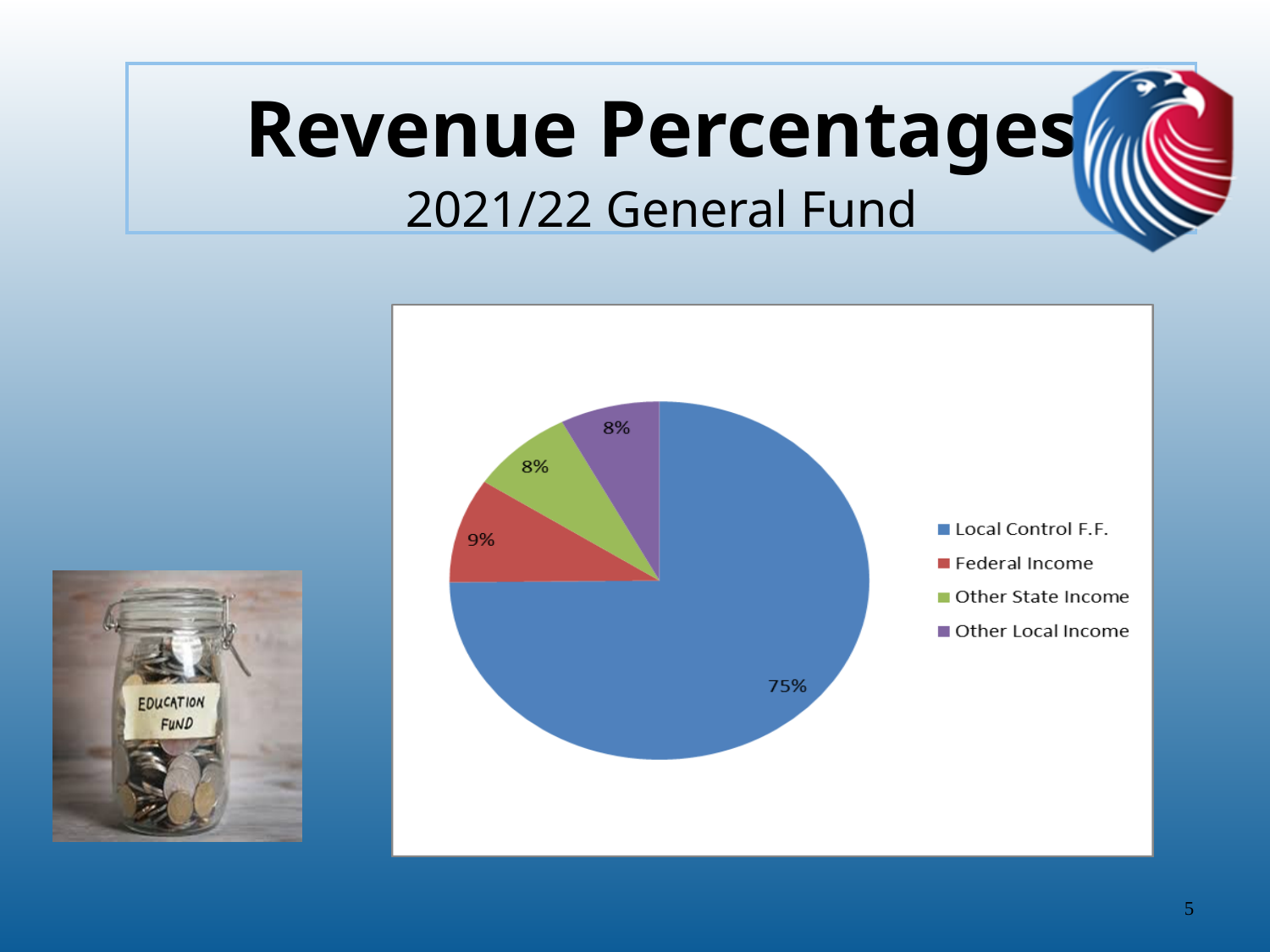
What percentage of the pie does Federal Income represent? 9% What percentage of the pie does Other Local Income represent? 8% What colour is the slice for Federal Income? Red What percentage of the pie does Other State Income represent? 8% How many slices does the pie chart have? 4 Which is larger, the share for Federal Income or the share for Other State Income? Federal Income What kind of chart is shown on the slide? Pie chart How many entries does the legend list? 4 What is the difference in percentage points between Federal Income and Other Local Income? 1 What is the difference in percentage points between Local Control F.F. and Federal Income? 66 Which category has the largest share of the pie? Local Control F.F.